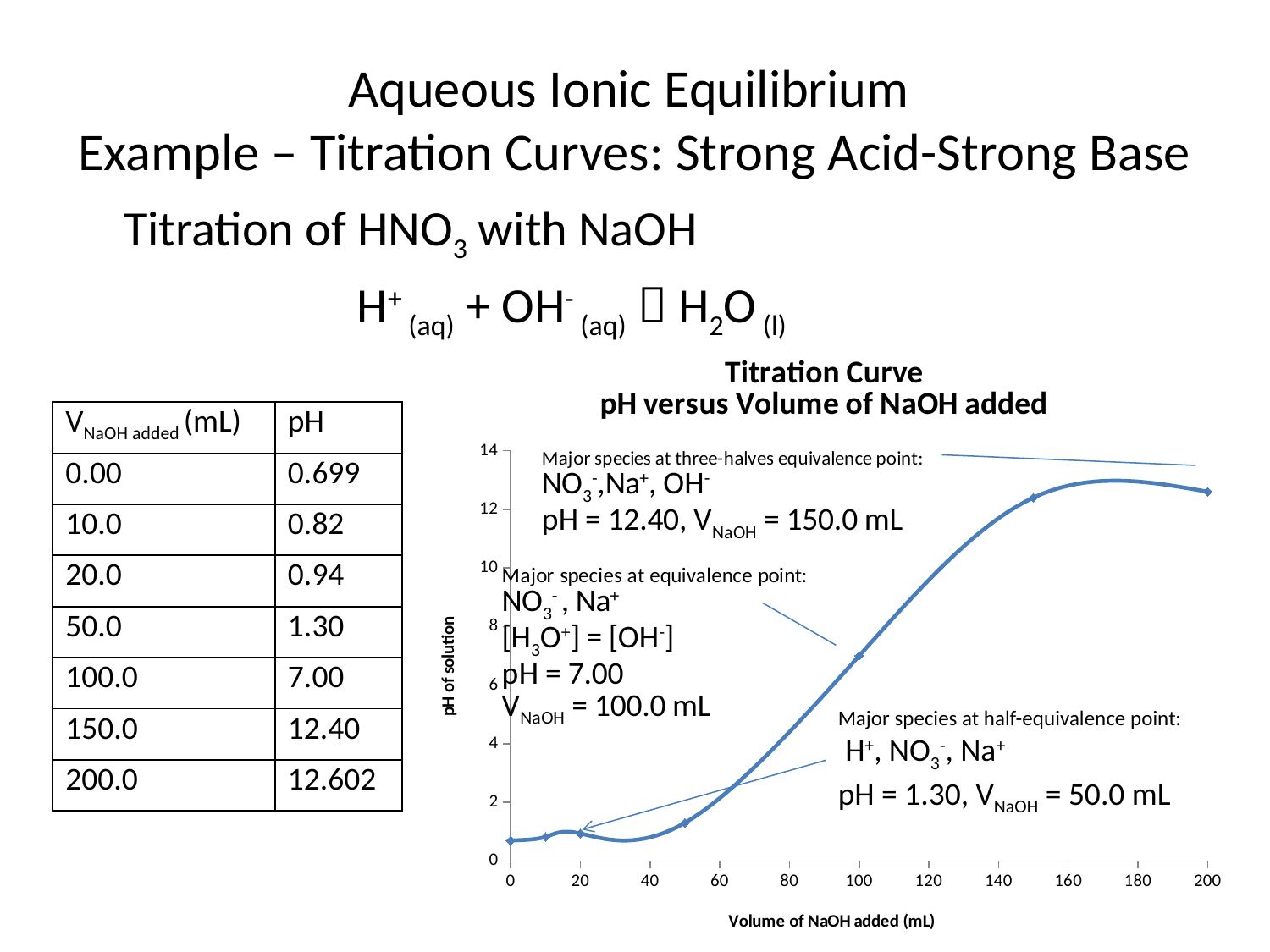
Is the pH at 20 mL of NaOH added greater or less than 2? less What is the difference in pH between the three-halves equivalence point (150.0 mL) and the half-equivalence point (50.0 mL)? 11.10 What is the pH at the equivalence point, where 100.0 mL of NaOH has been added? 7.00 Which has the higher pH: the point at 100 mL of NaOH added or the point at 50 mL? 100 mL Is the pH at 200 mL of NaOH added greater or less than 12? greater What kind of chart is shown on the slide? line chart What is the pH at the three-halves equivalence point, where 150.0 mL of NaOH has been added? 12.40 How many data points are plotted on the titration curve? 7 What is the pH at the half-equivalence point, where 50.0 mL of NaOH has been added? 1.30 What is the title of the chart? Titration Curve pH versus Volume of NaOH added Does the pH rise or fall overall as the volume of NaOH added increases from 0 to 200 mL? rise What is the label of the x axis of the chart? Volume of NaOH added (mL)